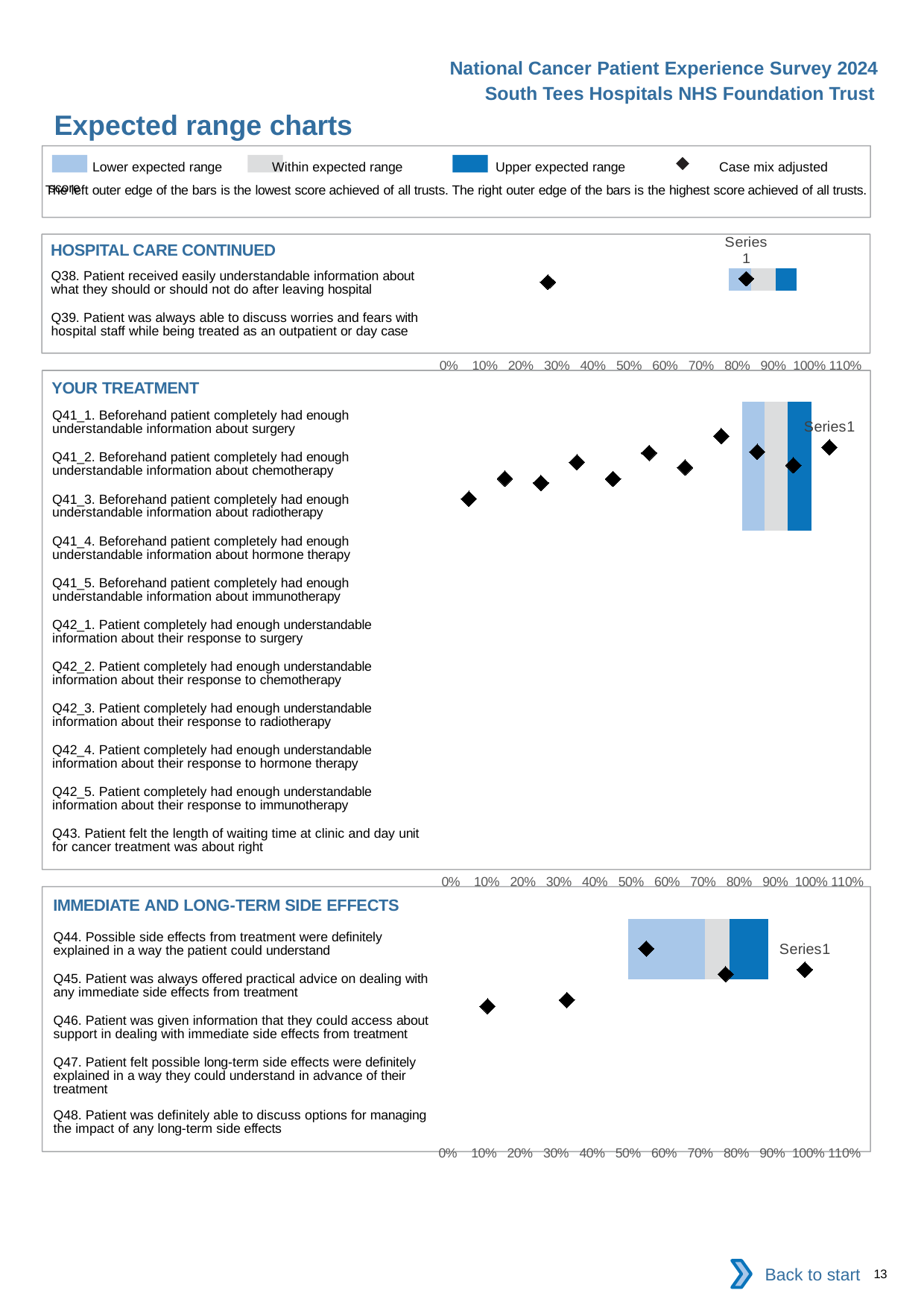
In the IMMEDIATE AND LONG-TERM SIDE EFFECTS chart, is the highest plotted diamond marker greater or less than 90%? greater Which legend entry is shown as a diamond marker rather than a coloured bar? Case mix adjusted score How many questions are listed in the IMMEDIATE AND LONG-TERM SIDE EFFECTS chart? 5 In the IMMEDIATE AND LONG-TERM SIDE EFFECTS chart, is the lowest plotted diamond marker greater or less than 30%? less How many entries does the legend at the top of the slide list? 4 How many questions are listed in the HOSPITAL CARE CONTINUED chart? 2 How many diamond markers are plotted in the HOSPITAL CARE CONTINUED chart? 2 What is the highest tick label shown on the x axis of the charts? 110% In the YOUR TREATMENT chart, is the lowest plotted diamond marker greater or less than 10%? less